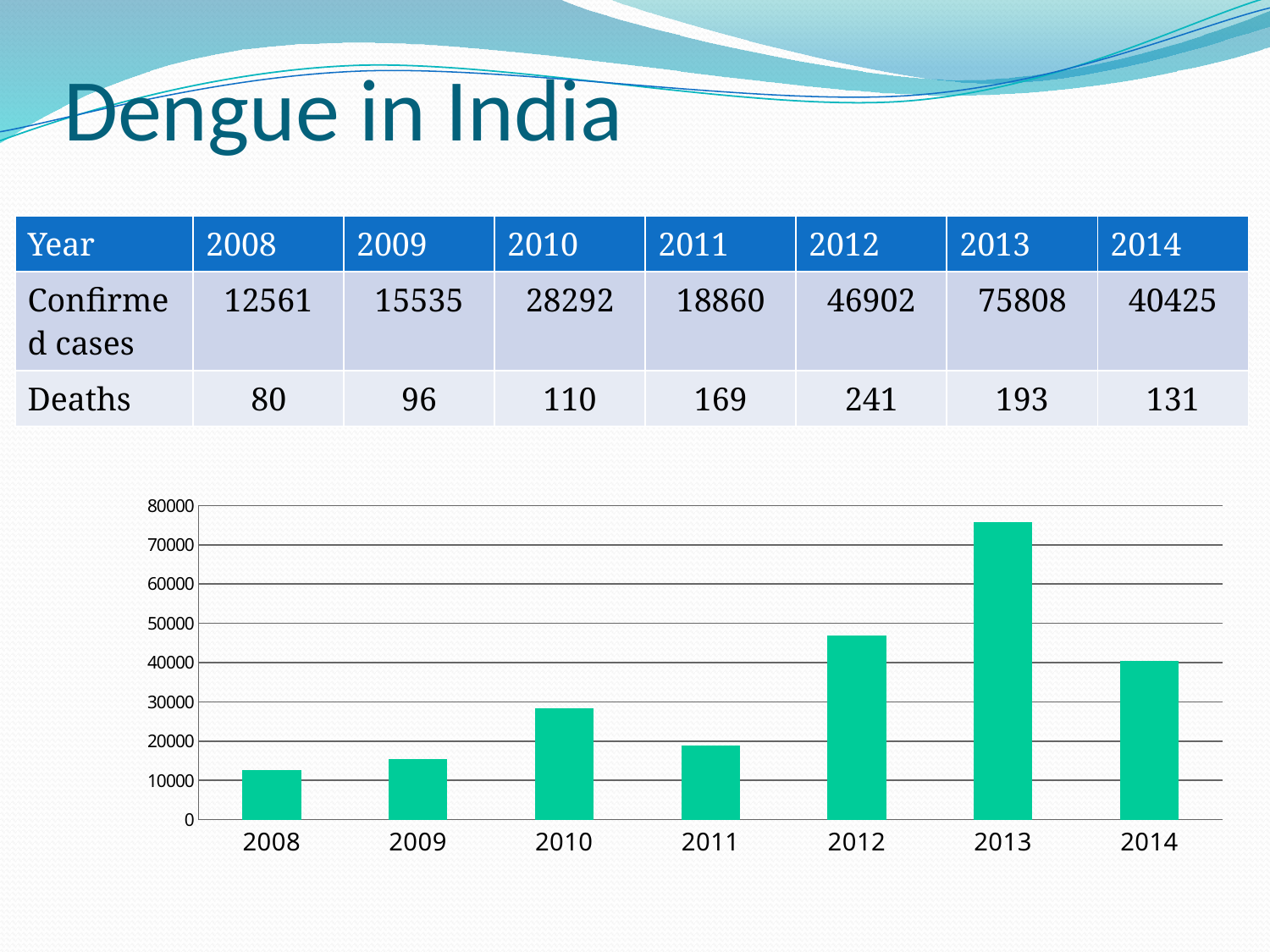
Is the bar for 2011 greater or less than 20000? less Which year has the shortest bar in the chart? 2008 Is the bar for 2013 greater or less than 70000? greater How many years are plotted on the bar chart? 7 Which year has the tallest bar in the chart? 2013 What is the highest value shown on the chart's vertical axis? 80000 Is the bar for 2012 greater or less than 40000? greater Which bar is taller, 2014 or 2012? 2012 According to the table on the slide, how many confirmed cases does the 2013 bar represent? 75808 What kind of chart is shown on the slide? bar chart Which bar is taller, 2010 or 2011? 2010